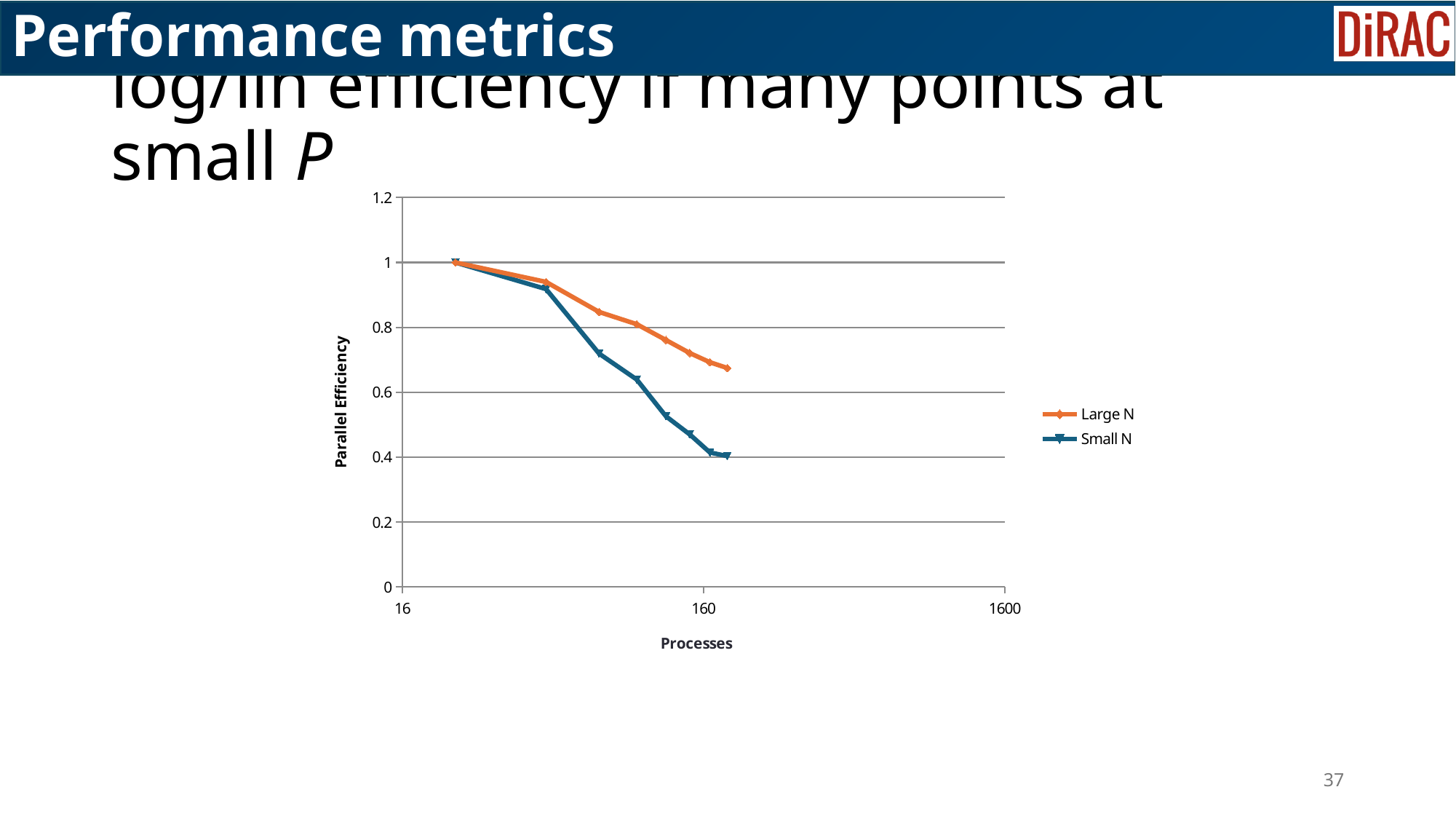
What is the starting value of the Small N series at the leftmost point? 1 Is the final (rightmost) value of the Large N series greater or less than 0.6? greater At the rightmost point, which series has the higher parallel efficiency, Large N or Small N? Large N What is the title of the vertical axis? Parallel Efficiency Is the final (rightmost) value of the Small N series greater or less than 0.5? less How many series does the chart's legend list? 2 What are the two series named in the legend? Large N and Small N What is the starting value of the Large N series at the leftmost point? 1 Do the parallel efficiency values rise or fall as the number of processes increases? fall What kind of chart is shown on the slide? line chart Is the final (rightmost) value of the Small N series greater or less than 0.6? less Which series shows the lowest parallel efficiency at around 160 processes? Small N